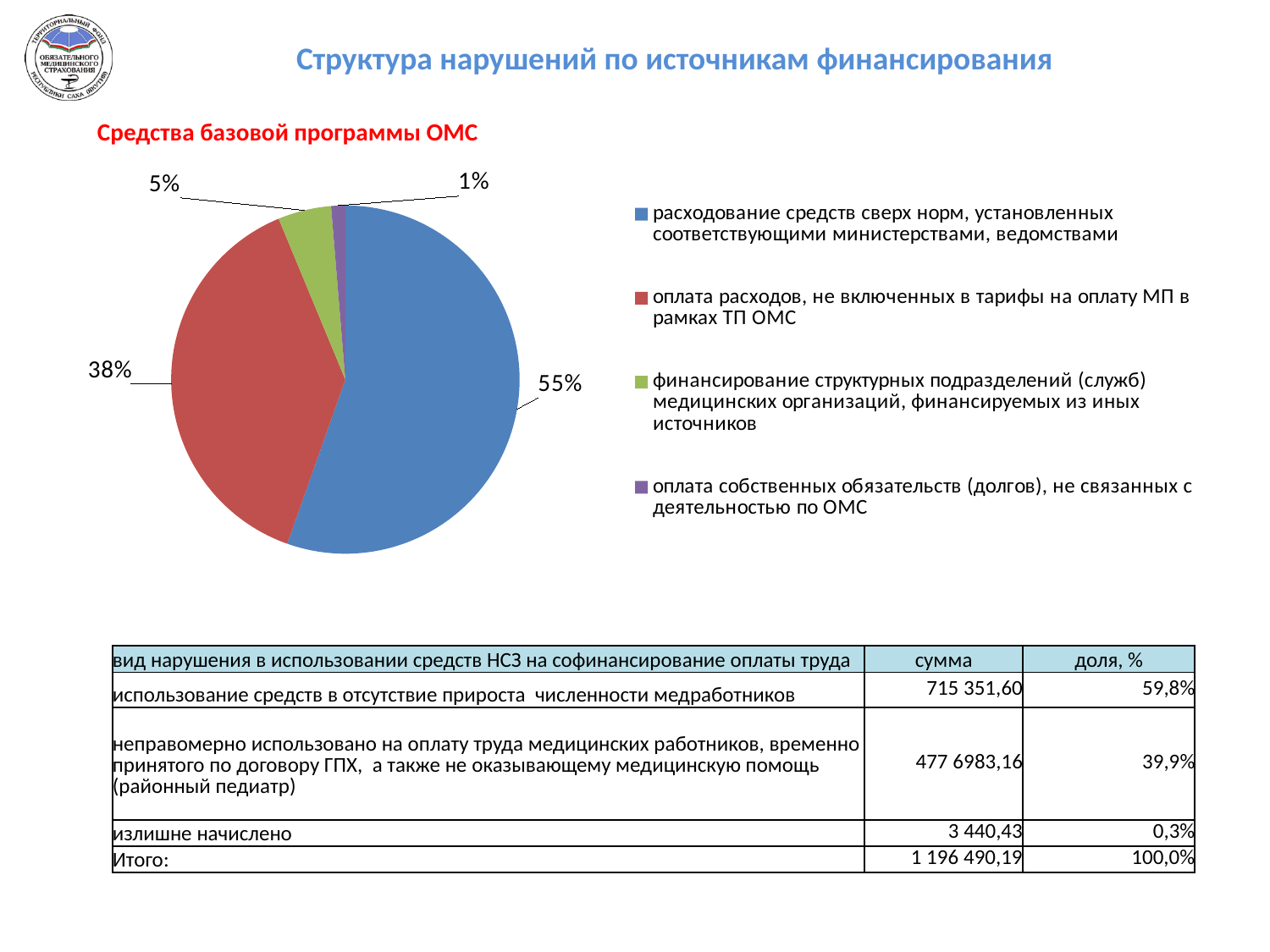
What share of the pie is "финансирование структурных подразделений (служб) медицинских организаций, финансируемых из иных источников"? 5% What is the difference in percentage points between the 55% slice and the 38% slice of the pie chart? 17 What kind of chart is shown under the heading "Средства базовой программы ОМС"? pie chart What share of the pie is "оплата расходов, не включенных в тарифы на оплату МП в рамках ТП ОМС"? 38% Which category has the largest slice of the pie chart? расходование средств сверх норм, установленных соответствующими министерствами, ведомствами What share of the pie is "оплата собственных обязательств (долгов), не связанных с деятельностью по ОМС"? 1% Which is larger in the pie chart: the slice for "оплата расходов, не включенных в тарифы на оплату МП в рамках ТП ОМС" or the slice for "финансирование структурных подразделений (служб) медицинских организаций, финансируемых из иных источников"? оплата расходов, не включенных в тарифы на оплату МП в рамках ТП ОМС How many slices does the pie chart have? 4 How many entries does the legend of the pie chart list? 4 Which category has the smallest slice of the pie chart? оплата собственных обязательств (долгов), не связанных с деятельностью по ОМС What colour is the slice representing "оплата расходов, не включенных в тарифы на оплату МП в рамках ТП ОМС" in the pie chart? red